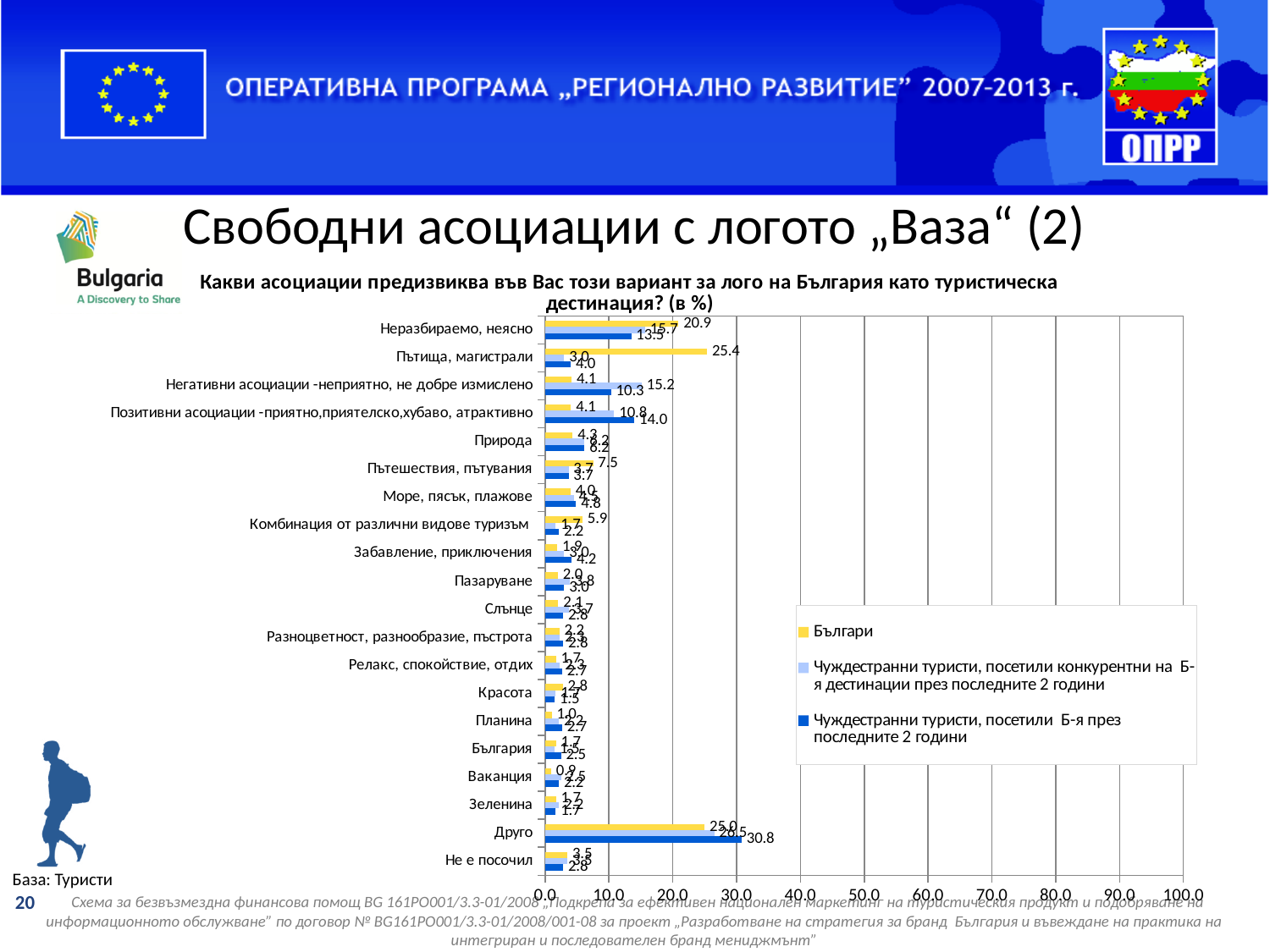
What is the value for Българи in the category Друго? 25.0 How many categories are plotted on the chart? 20 For the series Българи, which is larger: Пътища, магистрали or Неразбираемо, неясно? Пътища, магистрали What is the value for Българи in the category Пътища, магистрали? 25.4 How many series does the legend list? 3 For the series Българи, what is the difference between Пътища, магистрали and Неразбираемо, неясно? 4.5 What is the value for Чуждестранни туристи, посетили конкурентни на Б-я дестинации през последните 2 години in the category Негативни асоциации -неприятно, не добре измислено? 15.2 What is the value for Българи in the category Пътешествия, пътувания? 7.5 Which category has the highest value for the series Чуждестранни туристи, посетили Б-я през последните 2 години? Друго What is the value for Чуждестранни туристи, посетили Б-я през последните 2 години in the category Друго? 30.8 What is the value for Българи in the category Неразбираемо, неясно? 20.9 What kind of chart is shown on the slide? bar chart